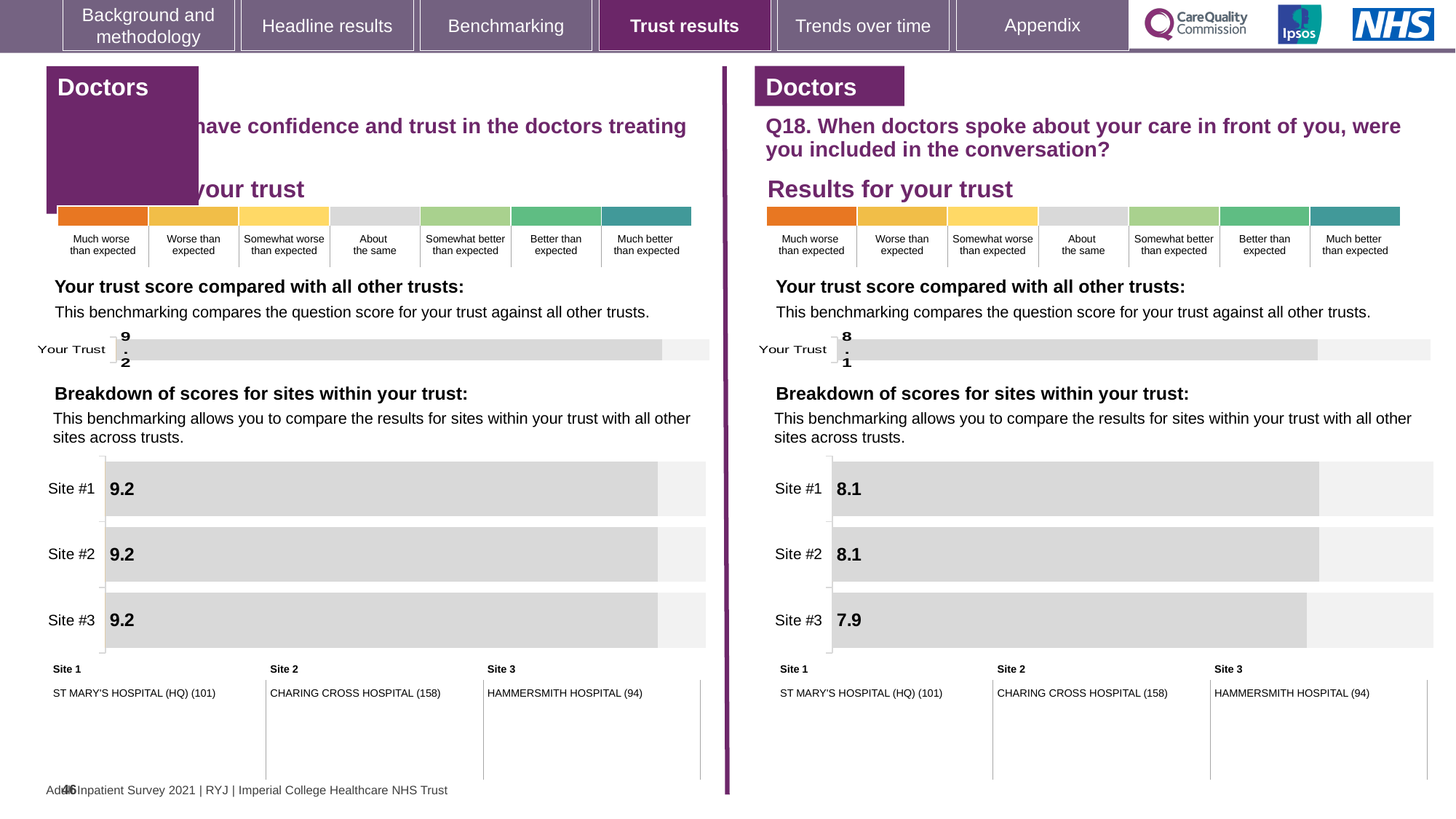
On the right-hand (Q18) 'Breakdown of scores for sites within your trust' chart, what is the score for Site #1? 8.1 How many sites are shown on the left-hand site breakdown chart? 3 On the right-hand (Q18) site breakdown chart, which site has the lowest score? Site #3 On the right-hand (Q18) site breakdown chart, which is larger, the score for Site #2 or Site #3? Site #2 On the left-hand site breakdown chart, do the scores for Site #1, Site #2 and Site #3 differ from each other? No, all are 9.2 On the left-hand 'Breakdown of scores for sites within your trust' chart, what is the score for Site #2? 9.2 What is the question text shown above the right-hand charts? Q18. When doctors spoke about your care in front of you, were you included in the conversation? On the left-hand 'Your trust score compared with all other trusts' chart, what is the value for Your Trust? 9.2 What kind of chart is the left-hand 'Breakdown of scores for sites within your trust' chart? Bar chart On the right-hand (Q18) site breakdown chart, what is the difference between the scores for Site #1 and Site #3? 0.2 On the right-hand (Q18) 'Breakdown of scores for sites within your trust' chart, what is the score for Site #3? 7.9 On the right-hand (Q18) 'Your trust score compared with all other trusts' chart, what is the value for Your Trust? 8.1